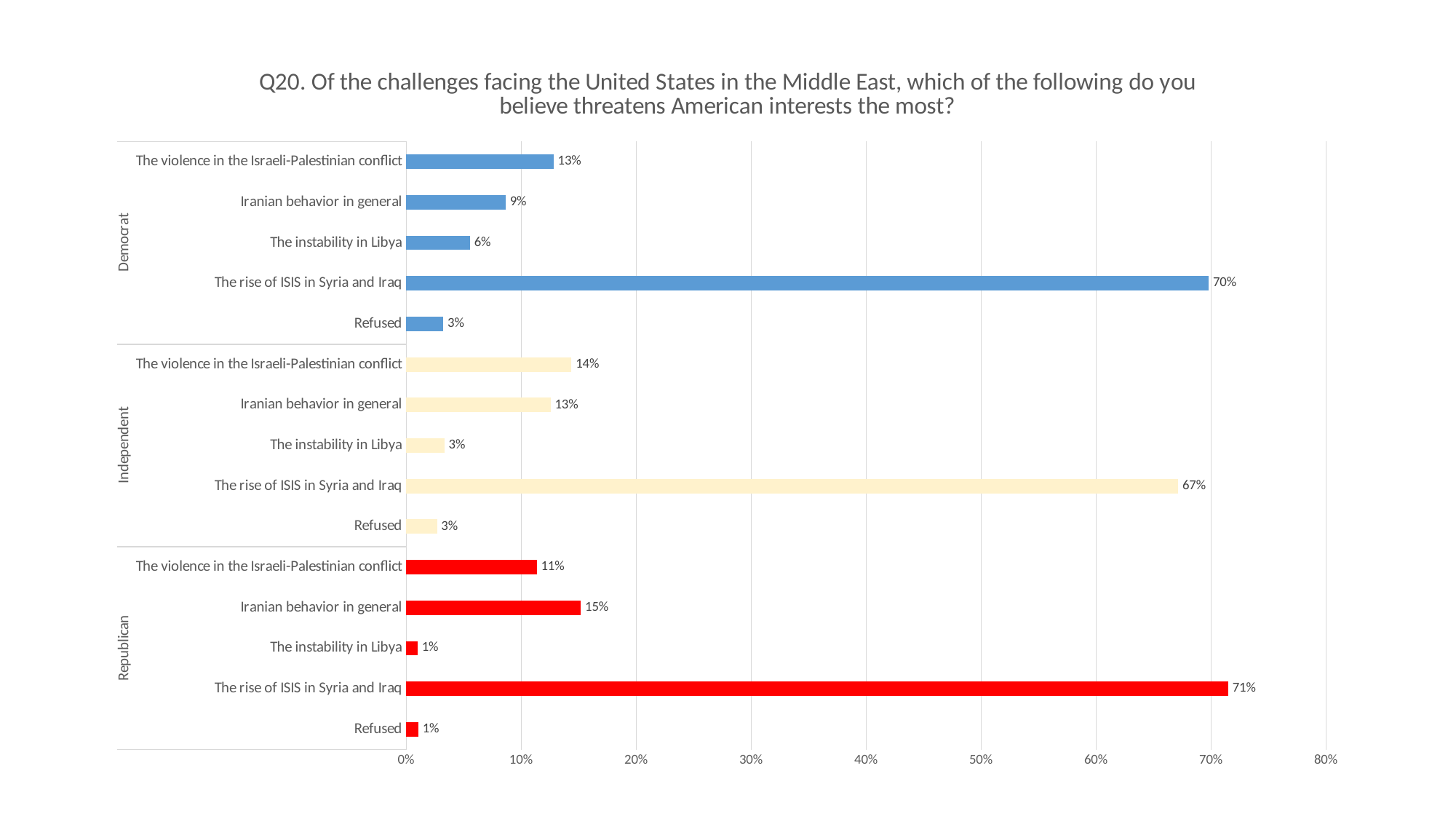
What percentage of Independents chose 'Iranian behavior in general'? 13% Is the Independent value for 'The rise of ISIS in Syria and Iraq' greater or less than 60%? greater What colour are the bars for the Republican group? Red What percentage of Democrats chose 'The rise of ISIS in Syria and Iraq'? 70% What is the difference between the Republican and Independent values for 'The rise of ISIS in Syria and Iraq'? 4% What percentage of Republicans chose 'The instability in Libya'? 1% How many party groups are shown on the vertical axis? 3 How many bars are plotted in the chart? 15 Which option has the highest value among Republicans? The rise of ISIS in Syria and Iraq What type of chart is shown on the slide? Bar chart Which is larger: the Democrat value for 'Iranian behavior in general' or the Republican value for 'Iranian behavior in general'? Republican Which option has the lowest value among Democrats? Refused